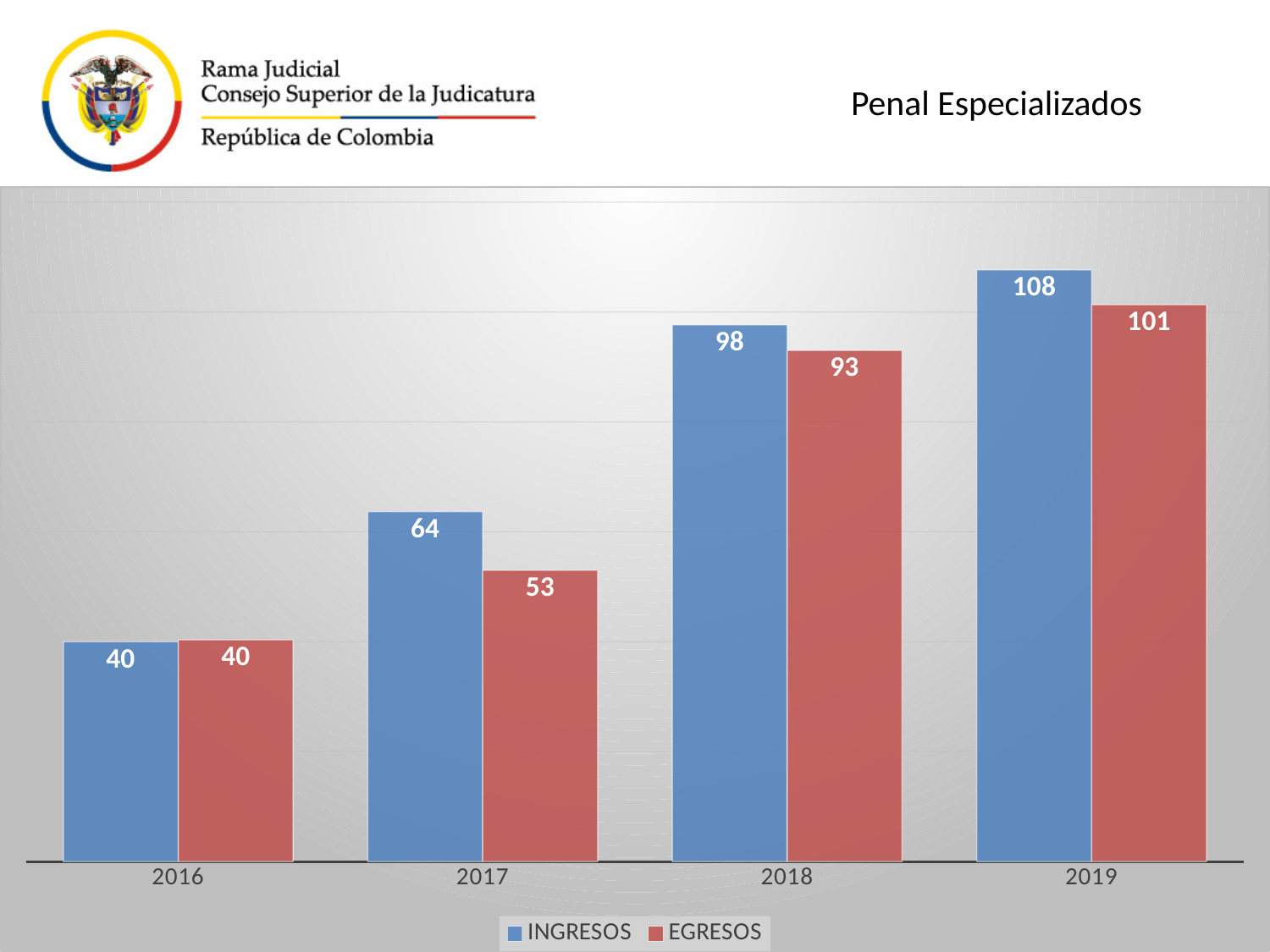
What kind of chart is shown on the slide? Bar chart Which is larger in 2018, INGRESOS or EGRESOS? INGRESOS What is the INGRESOS value for 2018? 98 Do the INGRESOS values rise or fall from 2016 to 2019? Rise What is the EGRESOS value for 2017? 53 Which year has the highest INGRESOS value? 2019 What is the EGRESOS value for 2019? 101 How many years are shown on the x axis? 4 What is the difference between INGRESOS in 2019 and INGRESOS in 2018? 10 How many series does the legend list? 2 Which year has the lowest EGRESOS value? 2016 What is the difference between INGRESOS and EGRESOS in 2017? 11